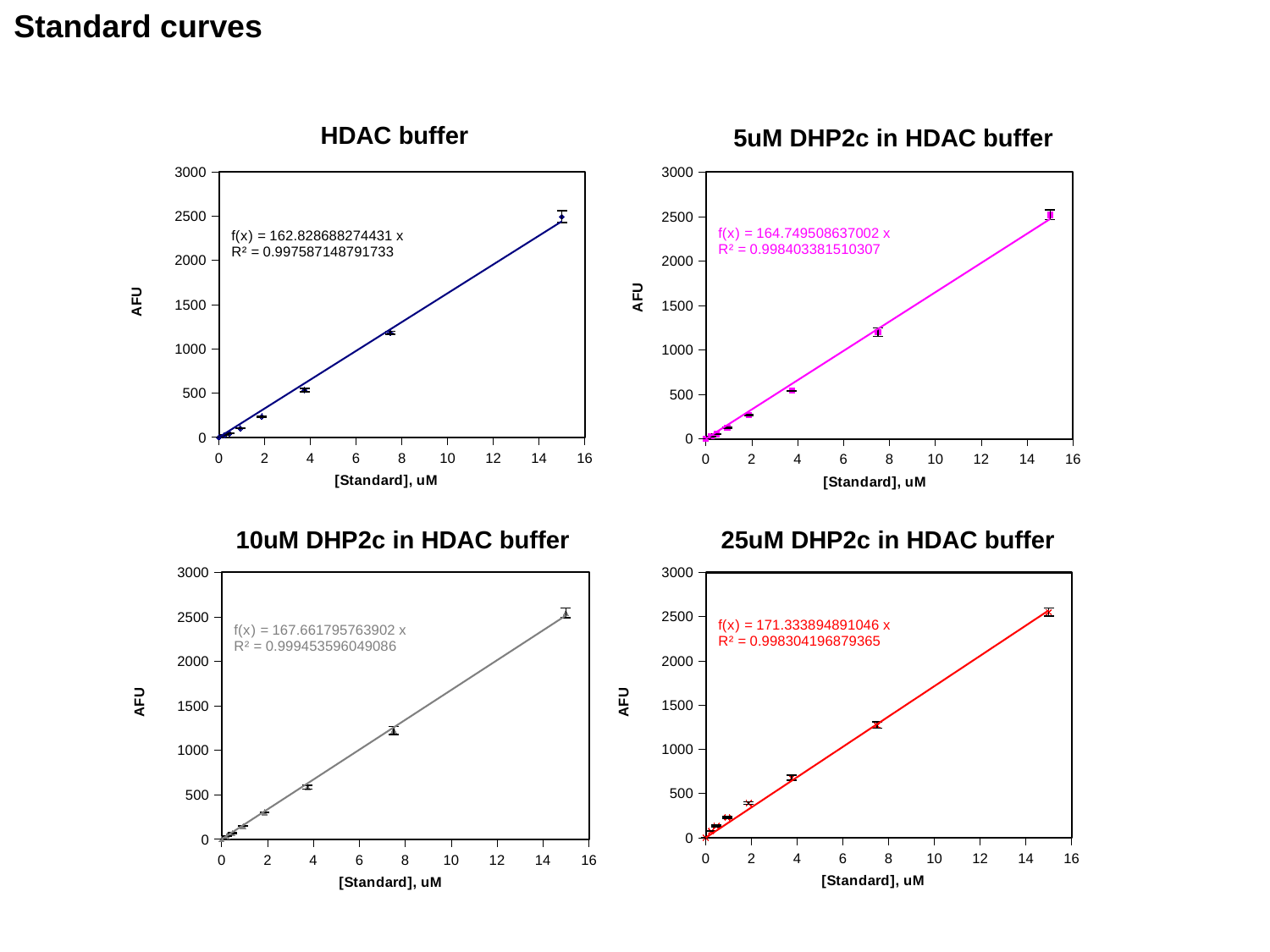
In the "5uM DHP2c in HDAC buffer" chart, is the AFU value at about 7.5 uM greater or less than 1500? less What is the R² value printed on the "10uM DHP2c in HDAC buffer" chart? 0.999453596049086 What is the label of the y axis on the "25uM DHP2c in HDAC buffer" chart? AFU What kind of chart is the "HDAC buffer" chart? scatter chart What is the maximum value shown on the y axis of the "HDAC buffer" chart? 3000 In the "10uM DHP2c in HDAC buffer" chart, is the AFU value at about 3.75 uM greater or less than 1000? less In the "25uM DHP2c in HDAC buffer" chart, do the AFU values rise or fall along the x axis? rise In the "HDAC buffer" chart, do the AFU values rise or fall as [Standard], uM increases? rise In the "HDAC buffer" chart, is the AFU value at 15 uM greater or less than 2000? greater In the "5uM DHP2c in HDAC buffer" chart, which plotted point has the highest AFU value: the one at 15 uM or the one at about 7.5 uM? 15 uM